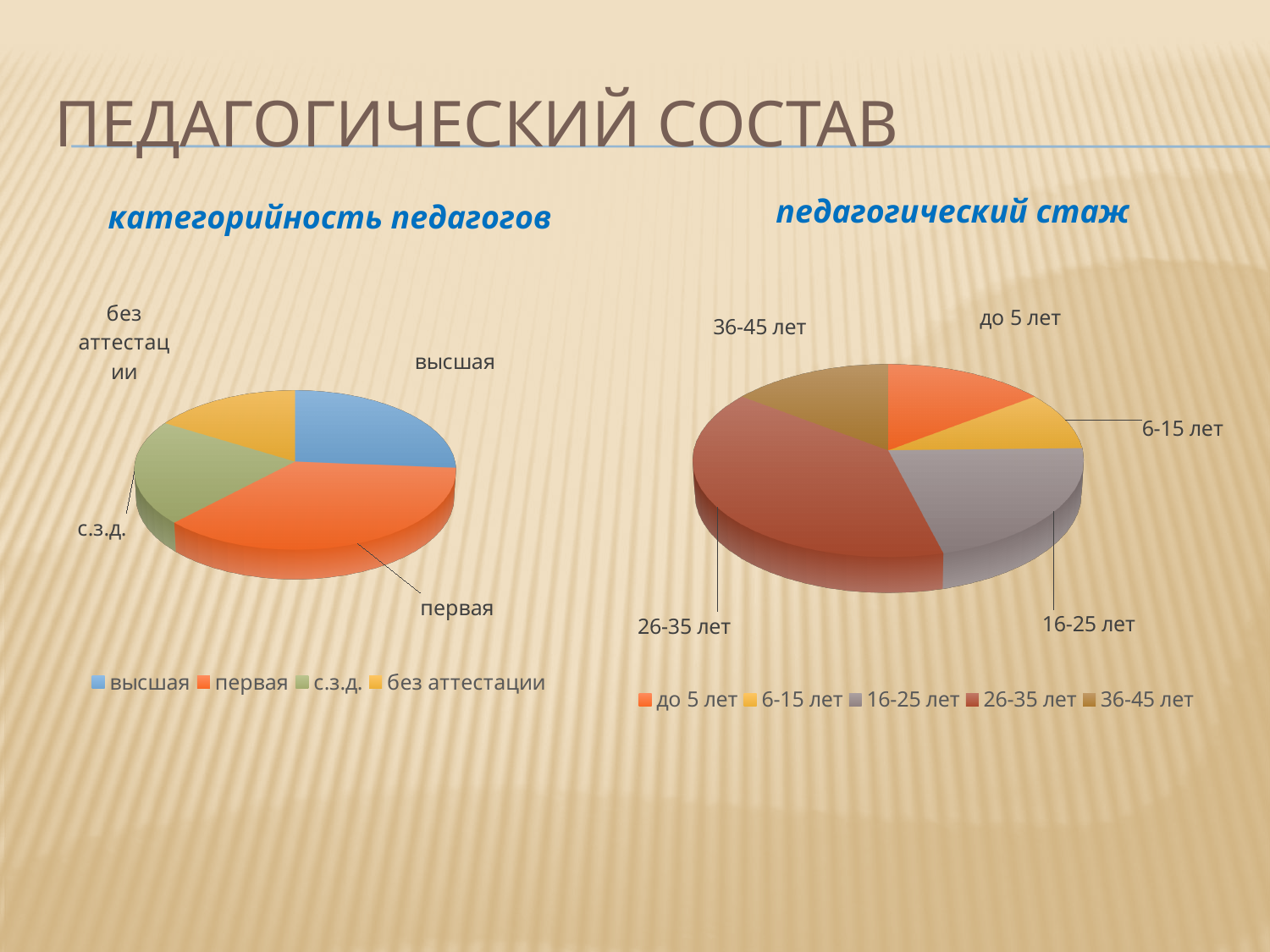
In the 'категорийность педагогов' chart, which slice is larger: первая or высшая? первая How many entries does the legend of the 'педагогический стаж' chart list? 5 In the 'категорийность педагогов' chart, what colour is the slice for высшая? blue In the 'педагогический стаж' chart, which slice is larger: 16-25 лет or до 5 лет? 16-25 лет In the 'педагогический стаж' chart, which category has the smallest slice? 6-15 лет How many entries does the legend of the 'категорийность педагогов' chart list? 4 In the 'категорийность педагогов' chart, which category has the largest slice? первая What kind of chart is the 'педагогический стаж' chart on the right? pie chart In the 'педагогический стаж' chart, how many slices does the pie have? 5 What kind of chart is the 'категорийность педагогов' chart on the left? pie chart In the 'категорийность педагогов' chart, how many slices does the pie have? 4 In the 'педагогический стаж' chart, which category has the largest slice? 26-35 лет